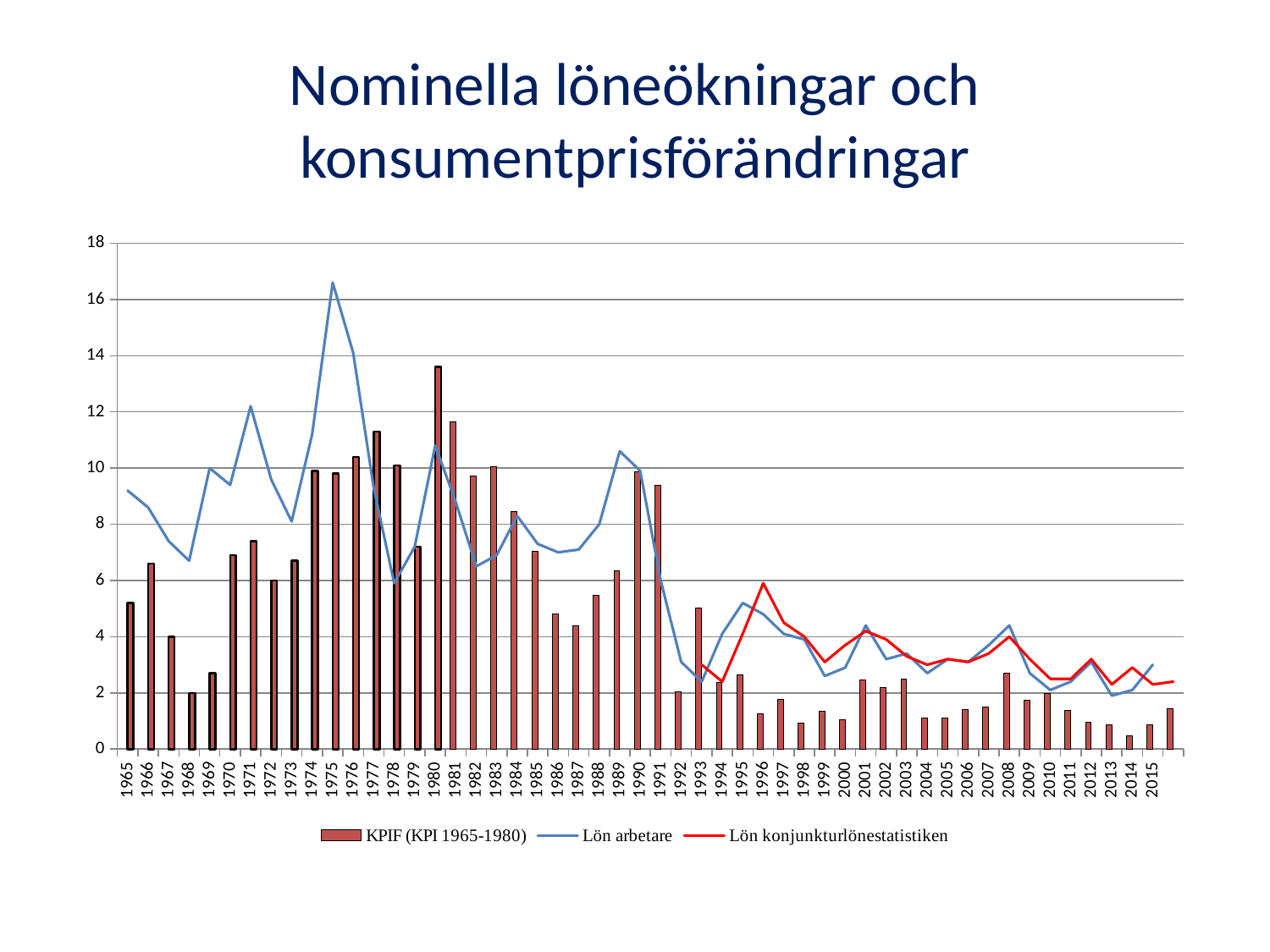
Is the KPIF (KPI 1965-1980) value for 1980 greater or less than 12? greater Which is larger, the KPIF (KPI 1965-1980) value for 1980 or for 1981? 1980 Is the Lön konjunkturlönestatistiken value for 1996 greater or less than 4? greater Is the KPIF (KPI 1965-1980) value for 1968 greater or less than 4? less How many series does the legend list? 3 Which is larger, the Lön arbetare value for 1971 or for 1972? 1971 What kind of chart is this? A combined bar and line chart Does the Lön arbetare line rise or fall from 1965 to 1968? fall In which year does the Lön arbetare line reach its highest value? 1975 In which year is the KPIF (KPI 1965-1980) bar lowest? 2014 In which year is the KPIF (KPI 1965-1980) bar highest? 1980